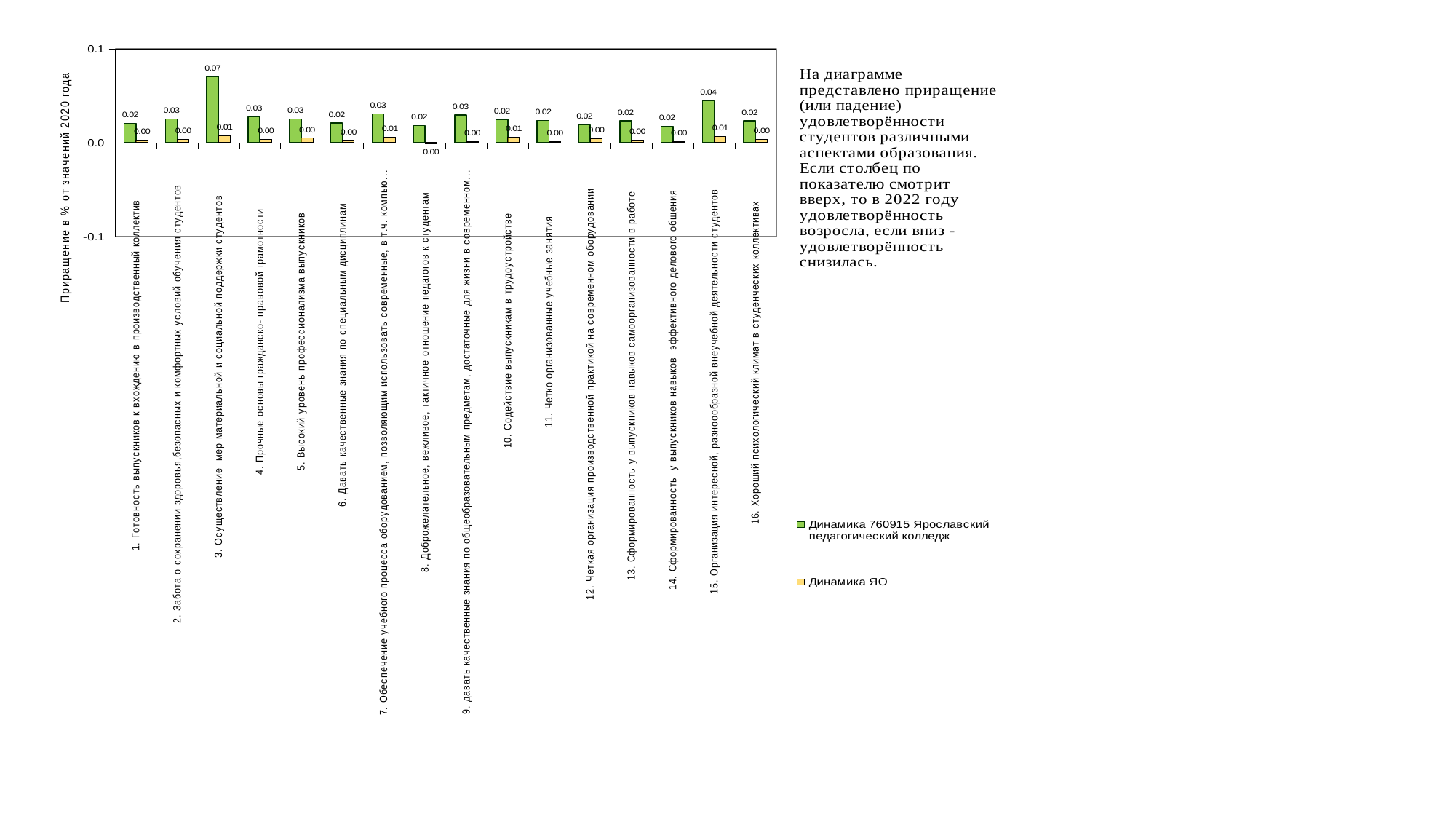
What colour are the bars for the series 'Динамика ЯО'? yellow What is the value of the series 'Динамика 760915 Ярославский педагогический колледж' for category '15. Организация интересной, разнообразной внеучебной деятельности студентов'? 0.04 What kind of chart is shown on the slide? bar chart Which category has the highest value for the series 'Динамика 760915 Ярославский педагогический колледж'? 3. Осуществление мер материальной и социальной поддержки студентов What is the value of the series 'Динамика 760915 Ярославский педагогический колледж' for category '3. Осуществление мер материальной и социальной поддержки студентов'? 0.07 What is the difference between the 'Динамика 760915 Ярославский педагогический колледж' value and the 'Динамика ЯО' value for category '3. Осуществление мер материальной и социальной поддержки студентов'? 0.06 How many categories are plotted along the x axis? 16 How many series does the legend list? 2 Is the value of 'Динамика 760915 Ярославский педагогический колледж' for category '3. Осуществление мер материальной и социальной поддержки студентов' greater or less than 0.1? less What is the value of the series 'Динамика ЯО' for category '10. Содействие выпускникам в трудоустройстве'? 0.01 For category '15. Организация интересной, разнообразной внеучебной деятельности студентов', which series has the larger value: 'Динамика 760915 Ярославский педагогический колледж' or 'Динамика ЯО'? Динамика 760915 Ярославский педагогический колледж What is the label of the vertical axis? Приращение в % от значений 2020 года